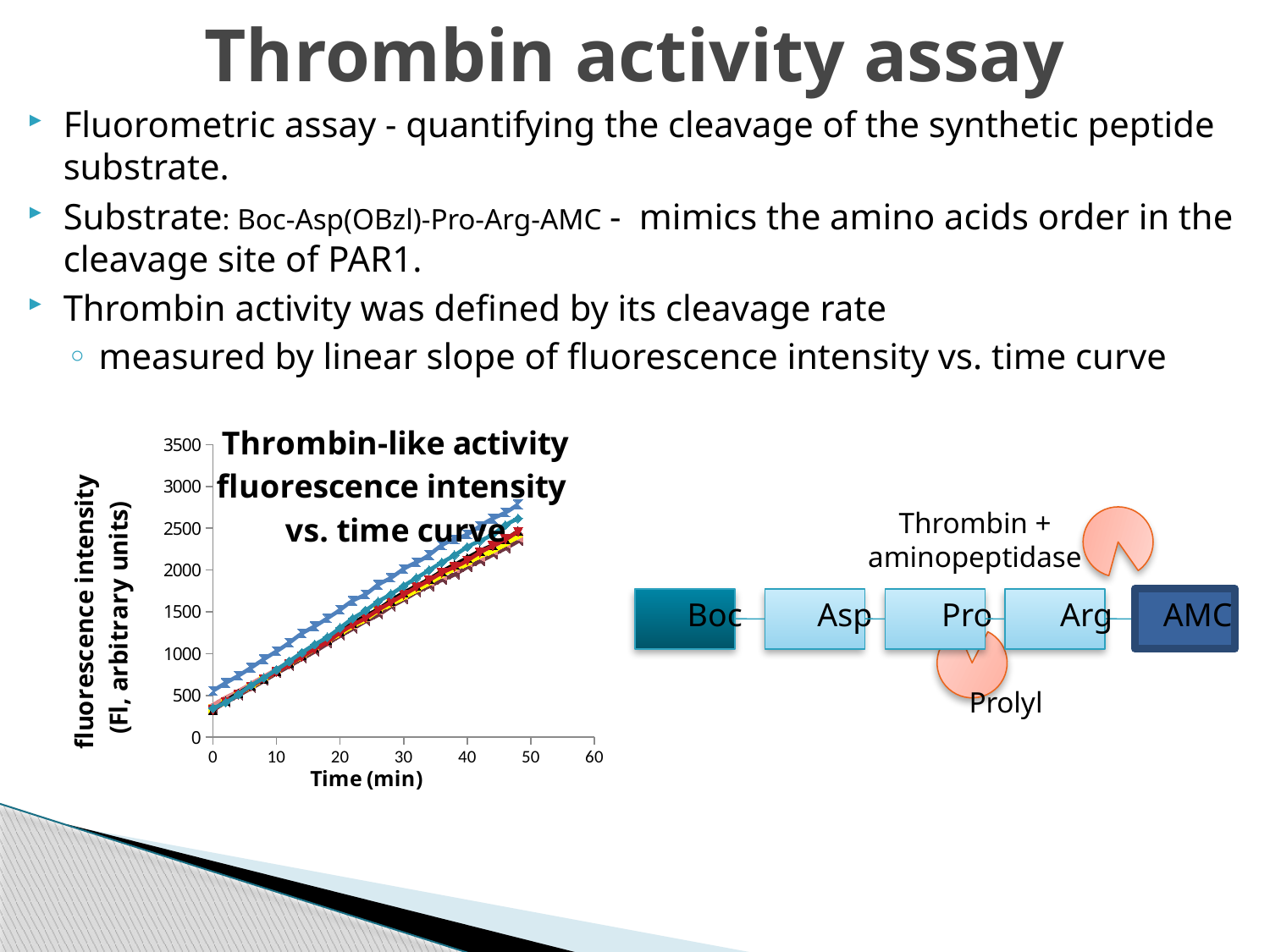
At time 0, are the fluorescence intensity values of the series greater or less than 1000? less Do the fluorescence intensity values rise or fall as time increases? rise What is the maximum value shown on the x axis of the chart? 60 What is the title of the chart? Thrombin-like activity fluorescence intensity vs. time curve What is the label of the x axis of the chart? Time (min) What kind of chart is shown on the slide? line chart Is the fluorescence intensity of the top series at 30 min greater or less than 1500? greater